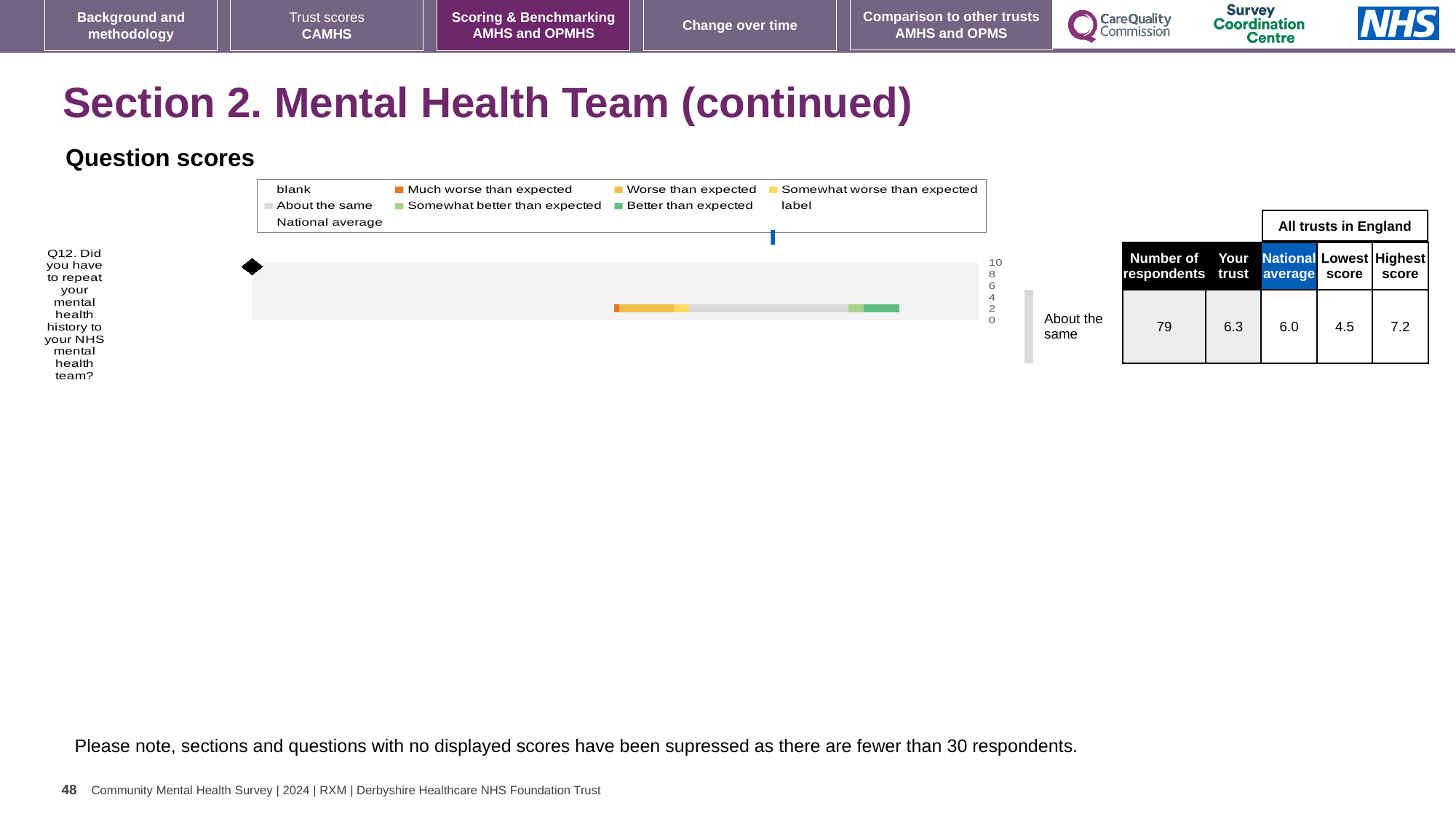
In the table beside the chart, what is the Highest score for Q12 across all trusts in England? 7.2 For Q12, what is the difference between the Highest score and the Lowest score across all trusts in England? 2.7 What kind of chart is used to show the Q12 question score? bar chart For Q12, what is the difference between the Your trust score and the National average score? 0.3 How many survey questions are plotted in the Question scores chart? 1 In the table beside the chart, what is the Lowest score for Q12 across all trusts in England? 4.5 What rating label is shown to the right of the Q12 bar? About the same Which question number is plotted in the Question scores chart? Q12 In the table beside the chart, how many respondents answered Q12? 79 In the table beside the chart, what is the Your trust score for Q12? 6.3 In the table beside the chart, what is the National average score for Q12? 6.0 For Q12, which is higher: the Your trust score or the National average score? Your trust